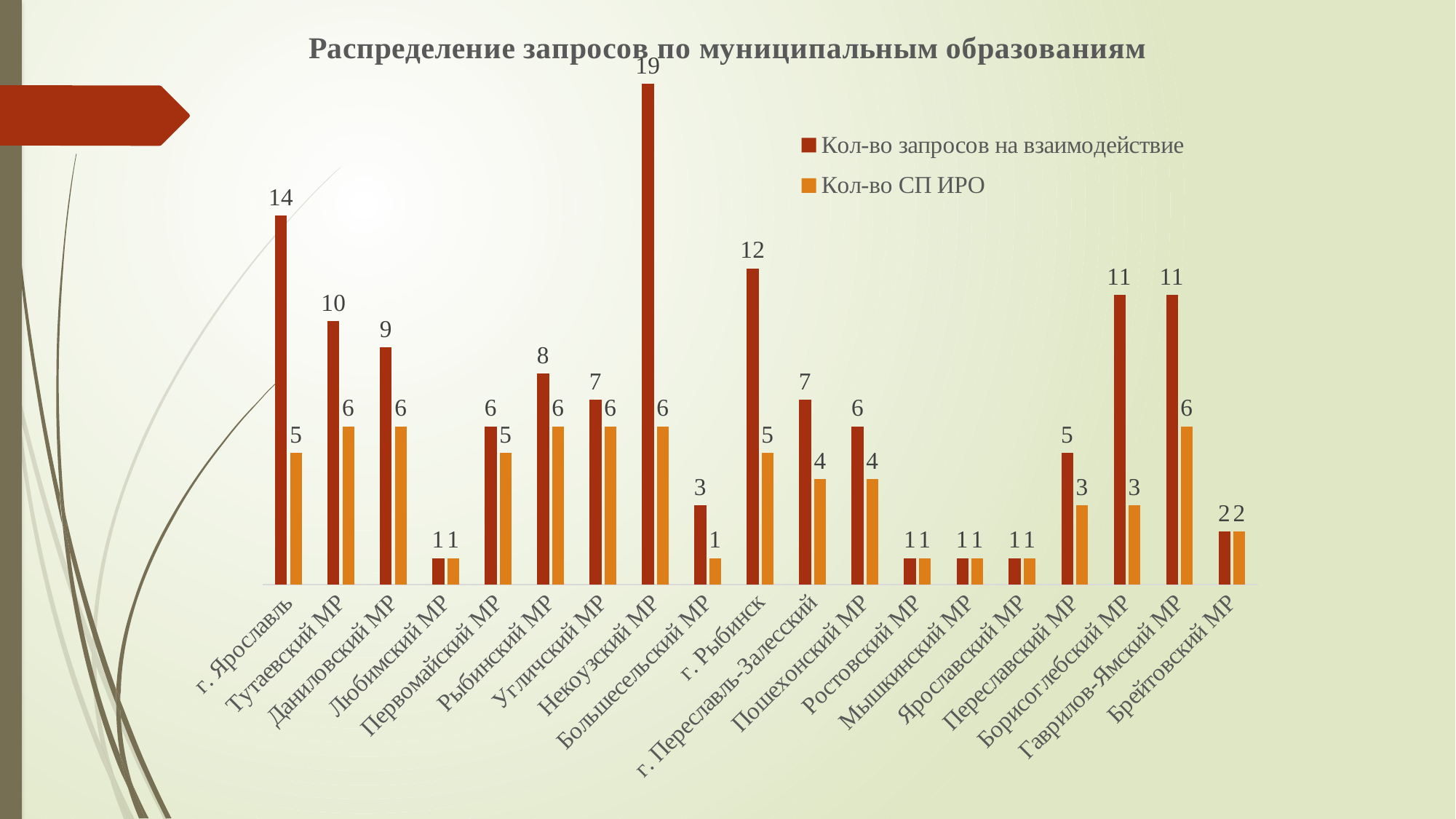
What is the title of the chart? Распределение запросов по муниципальным образованиям What is the value of "Кол-во СП ИРО" for г. Ярославль? 5 How many series does the legend list? 2 Which category has the highest value for "Кол-во запросов на взаимодействие"? Некоузский МР Which is larger: "Кол-во запросов на взаимодействие" for Тутаевский МР or for Даниловский МР? Тутаевский МР How many categories are shown on the x axis? 19 What is the difference between "Кол-во запросов на взаимодействие" for Некоузский МР and for г. Рыбинск? 7 What is the value of "Кол-во запросов на взаимодействие" for г. Рыбинск? 12 What is the value of "Кол-во СП ИРО" for Борисоглебский МР? 3 What is the difference between "Кол-во запросов на взаимодействие" and "Кол-во СП ИРО" for г. Ярославль? 9 What is the value of "Кол-во запросов на взаимодействие" for Некоузский МР? 19 What kind of chart is shown on the slide? Bar chart